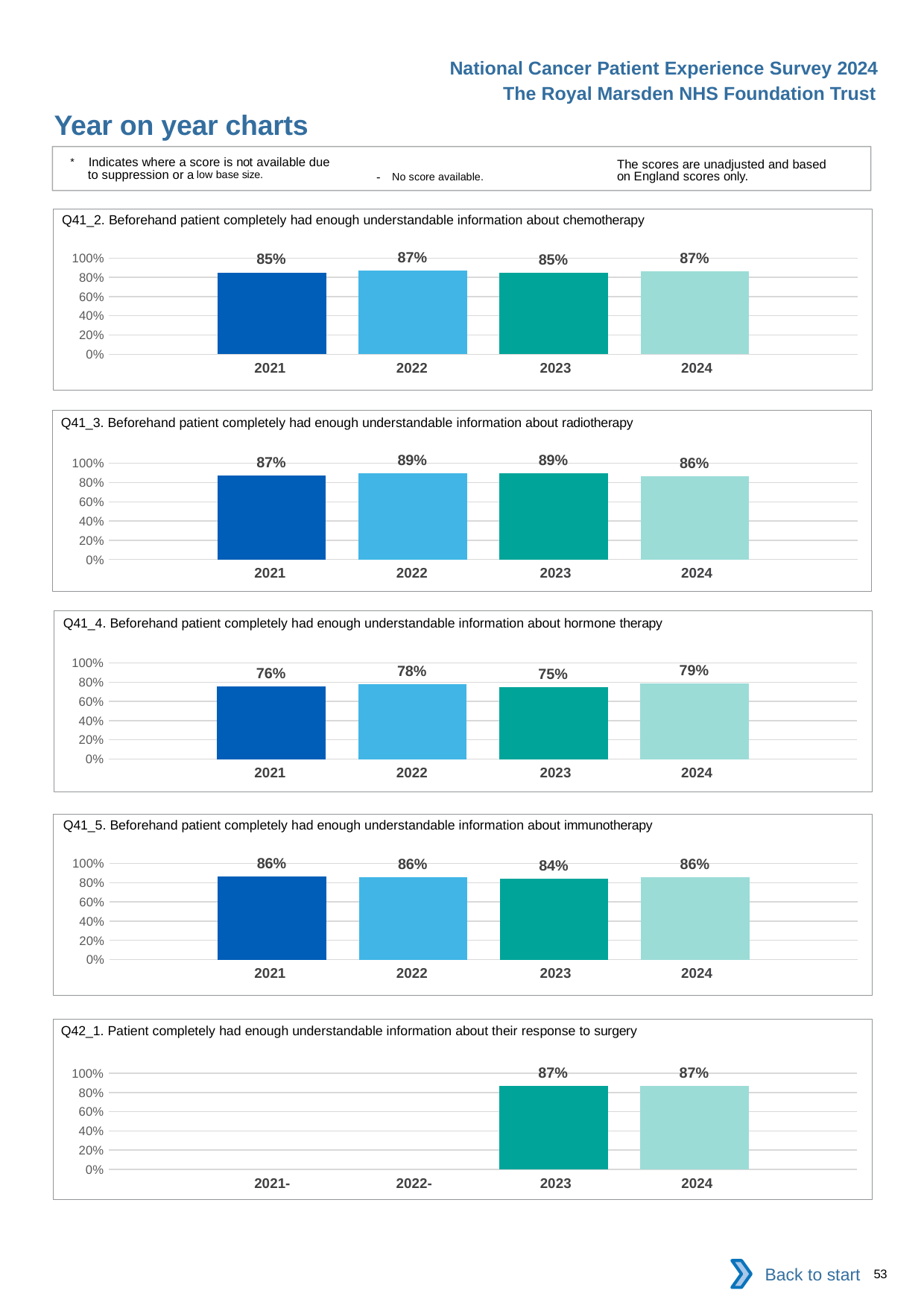
In the Q41_5 chart (immunotherapy), what is the value for 2023? 84% In the Q42_1 chart (response to surgery), how many years have a bar plotted? 2 What kind of chart is the Q41_2 chart (chemotherapy)? bar chart In the Q41_4 chart (hormone therapy), which year has the highest value? 2024 In the Q41_3 chart (radiotherapy), is the 2022 value larger or smaller than the 2021 value? larger In the Q42_1 chart (response to surgery), what is the value for 2024? 87% In the Q41_5 chart (immunotherapy), which year has the lowest value? 2023 In the Q41_2 chart (chemotherapy), what is the value for 2022? 87% In the Q41_3 chart (radiotherapy), which year has the lowest value? 2024 In the Q41_4 chart (hormone therapy), is the value for 2023 greater or less than 80%? less How many charts are shown on the slide? 5 In the Q41_4 chart (hormone therapy), what is the difference between the 2024 and 2023 values? 4%